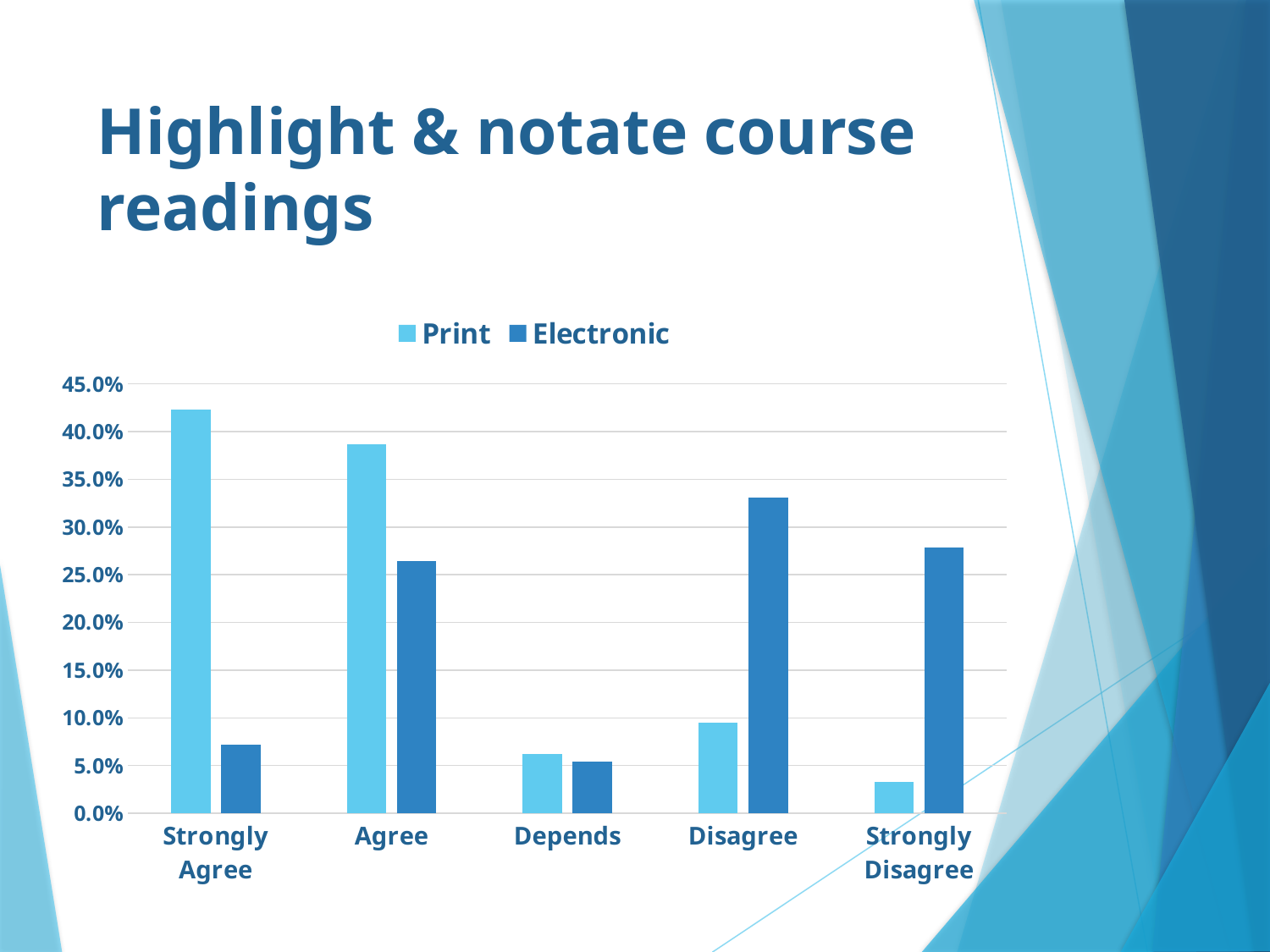
Is the Electronic value for Disagree greater or less than 30.0%? greater Is the Print value for Strongly Agree greater or less than 40.0%? greater How many categories are shown on the x axis? 5 Which category has the lowest value for the Print series? Strongly Disagree What are the two series named in the legend? Print and Electronic For Disagree, which series has the larger value, Print or Electronic? Electronic What kind of chart is shown on the slide? bar chart How many series does the legend list? 2 Which category has the highest value for the Electronic series? Disagree For Strongly Agree, which series has the larger value, Print or Electronic? Print Is the Print value for Strongly Disagree greater or less than 5.0%? less Which category has the highest value for the Print series? Strongly Agree